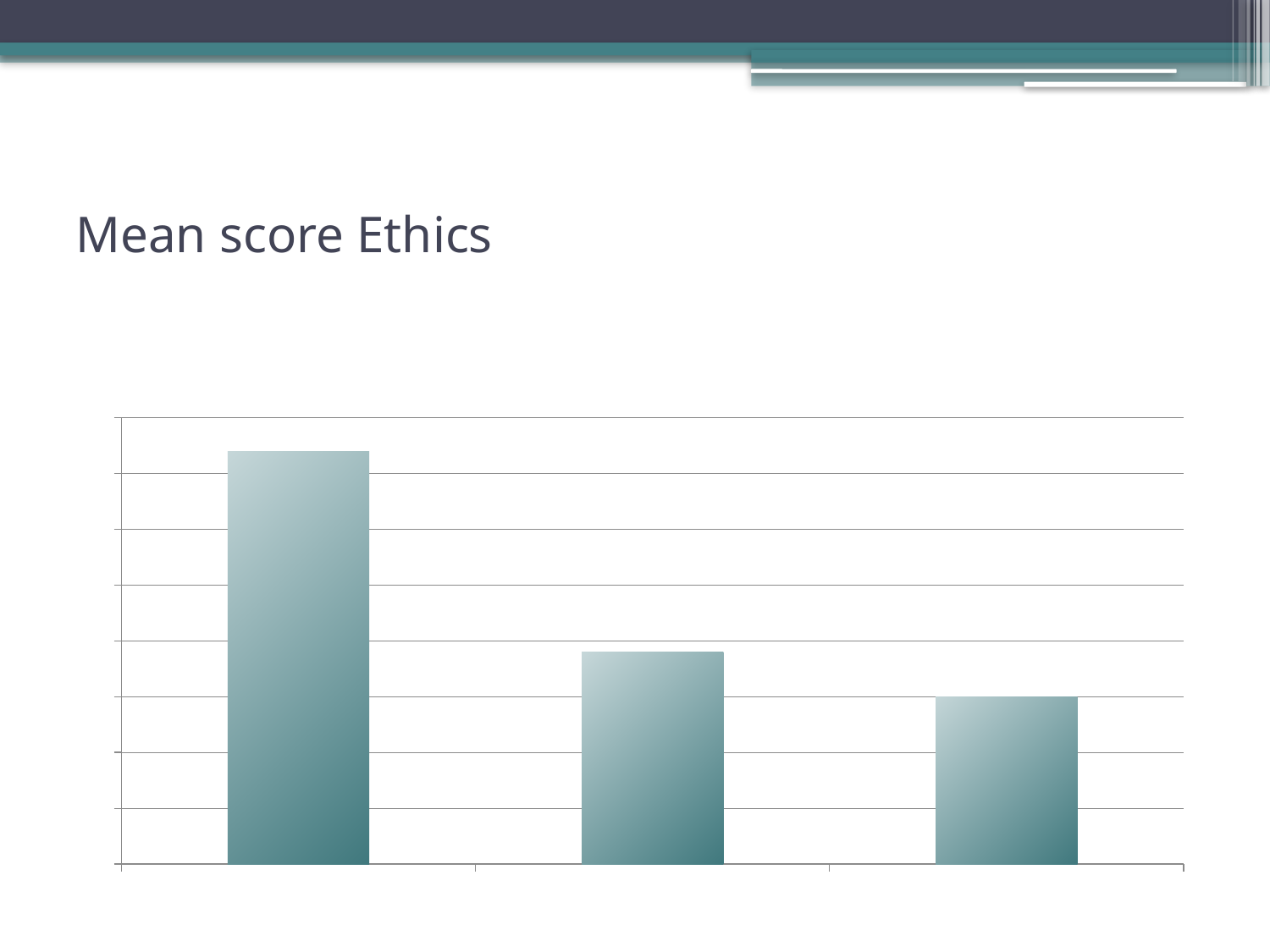
Which is taller, the middle bar or the right bar? the middle bar How many bars does the chart show? 3 Which bar is the shortest: the left, middle, or right bar? right Which bar is the tallest: the left, middle, or right bar? left What kind of chart is shown on the slide? bar chart Does the chart display a legend? No Which is taller, the left bar or the middle bar? the left bar Do the bar values rise or fall from left to right across the chart? fall What is the title shown on the slide above the chart? Mean score Ethics